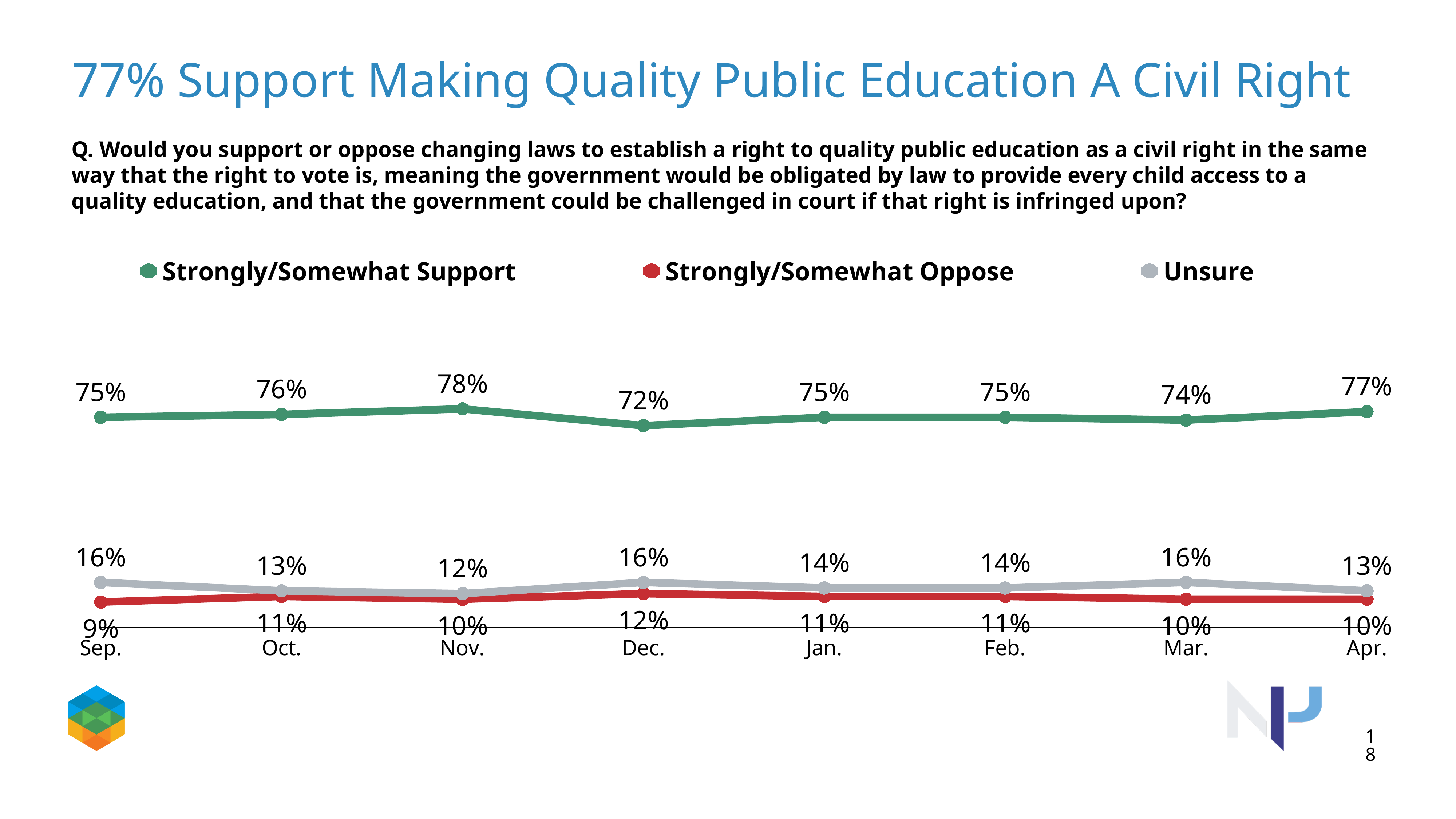
Which colour represents the Unsure series? Grey What is the difference between the Strongly/Somewhat Support values for Nov. and Dec.? 6% In which month is Strongly/Somewhat Support highest? Nov. What is the Strongly/Somewhat Oppose value for Dec.? 12% How many months are shown on the x axis? 8 What is the Strongly/Somewhat Support value for Dec.? 72% In which month is Strongly/Somewhat Support lowest? Dec. What kind of chart is shown on the slide? Line chart What is the Unsure value for Sep.? 16% In which month is Strongly/Somewhat Oppose lowest? Sep. How many series does the legend list? 3 Which is larger in Apr., Unsure or Strongly/Somewhat Oppose? Unsure